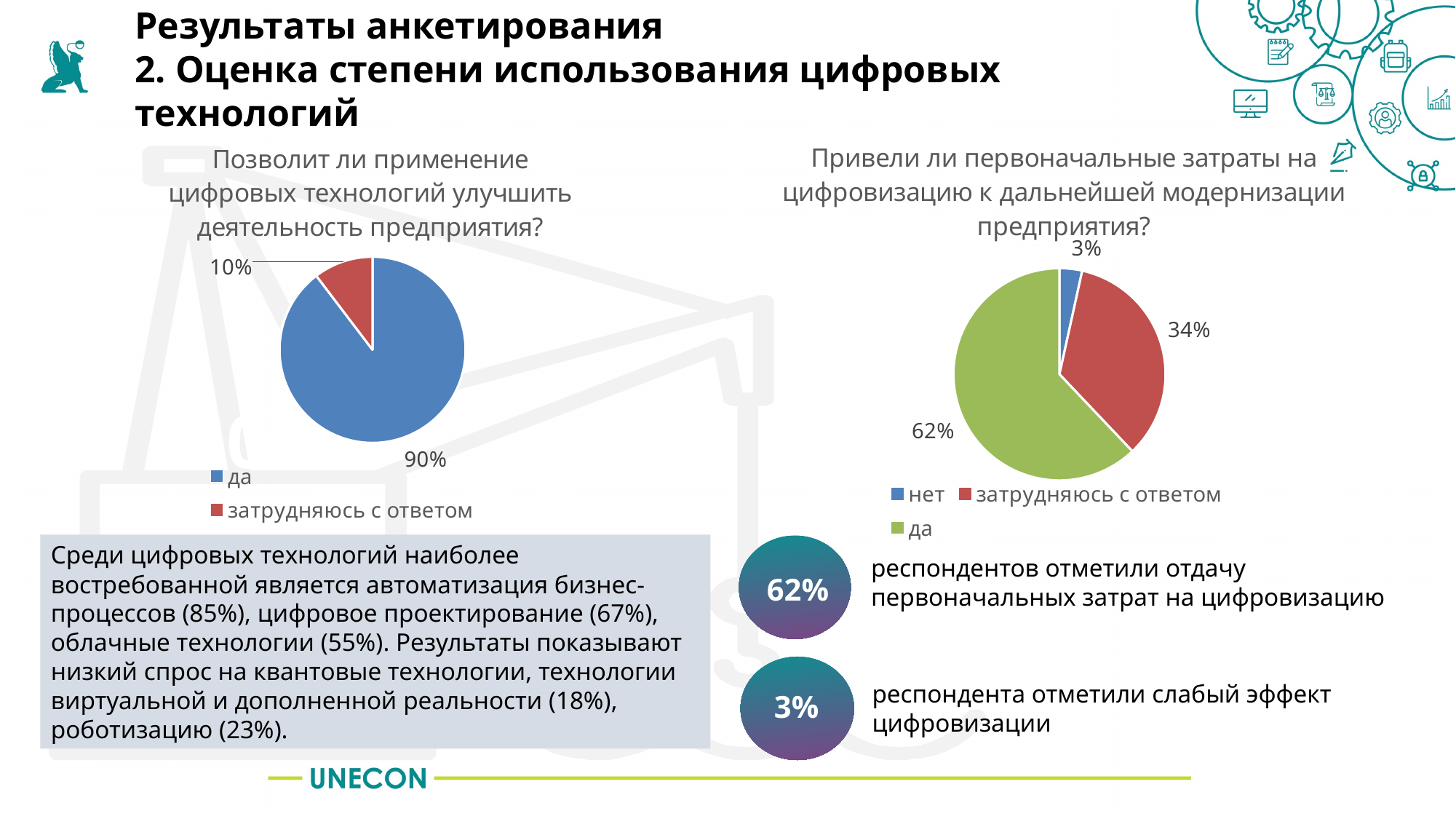
In the right pie chart ("Привели ли первоначальные затраты на цифровизацию к дальнейшей модернизации предприятия?"), what share of respondents answered "да"? 62% In the left pie chart, what is the difference between the shares for "да" and "затрудняюсь с ответом"? 80% In the right pie chart, which answer has the smallest share? нет In the left pie chart ("Позволит ли применение цифровых технологий улучшить деятельность предприятия?"), what share of respondents answered "да"? 90% In the left pie chart, what share of respondents answered "затрудняюсь с ответом"? 10% In the right pie chart, what share of respondents answered "затрудняюсь с ответом"? 34% In the right pie chart, which answer has the largest share? да In the right pie chart, what is the difference between the shares for "да" and "затрудняюсь с ответом"? 28% In the right pie chart, what share of respondents answered "нет"? 3% How many categories does the legend of the right pie chart list? 3 How many slices does the left pie chart have? 2 What type of chart is used on the left side of the slide? Pie chart